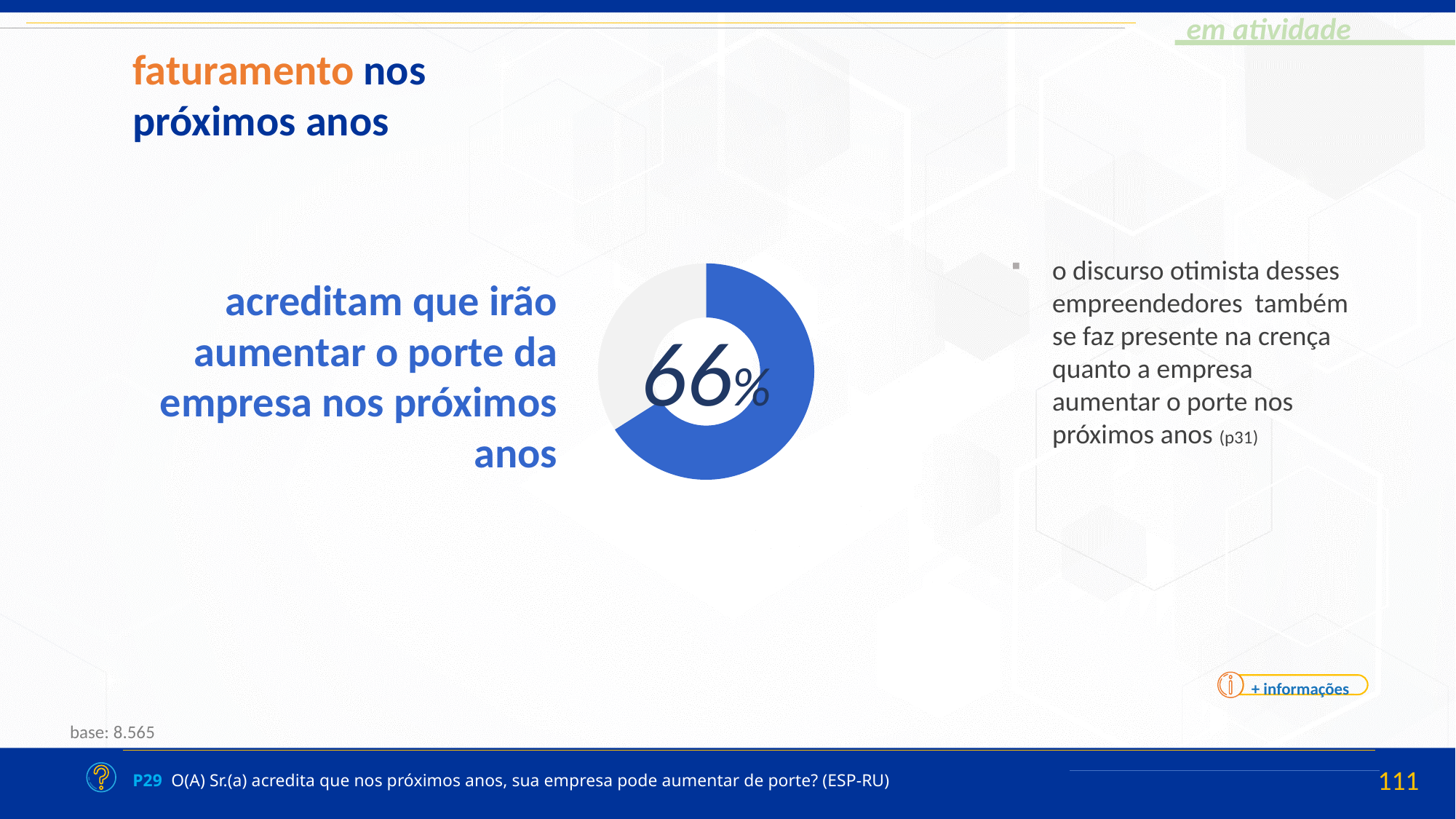
What kind of chart is shown on the slide? pie chart (donut) What is the base (number of respondents) stated for the chart? 8.565 What percentage is shown in the centre of the donut chart? 66% How many segments does the donut chart have? 2 What share of respondents believe they will increase the size of their company in the coming years, according to the chart? 66% What does the 66% in the donut chart represent? acreditam que irão aumentar o porte da empresa nos próximos anos Which segment of the donut chart is larger, the blue one or the grey one? blue